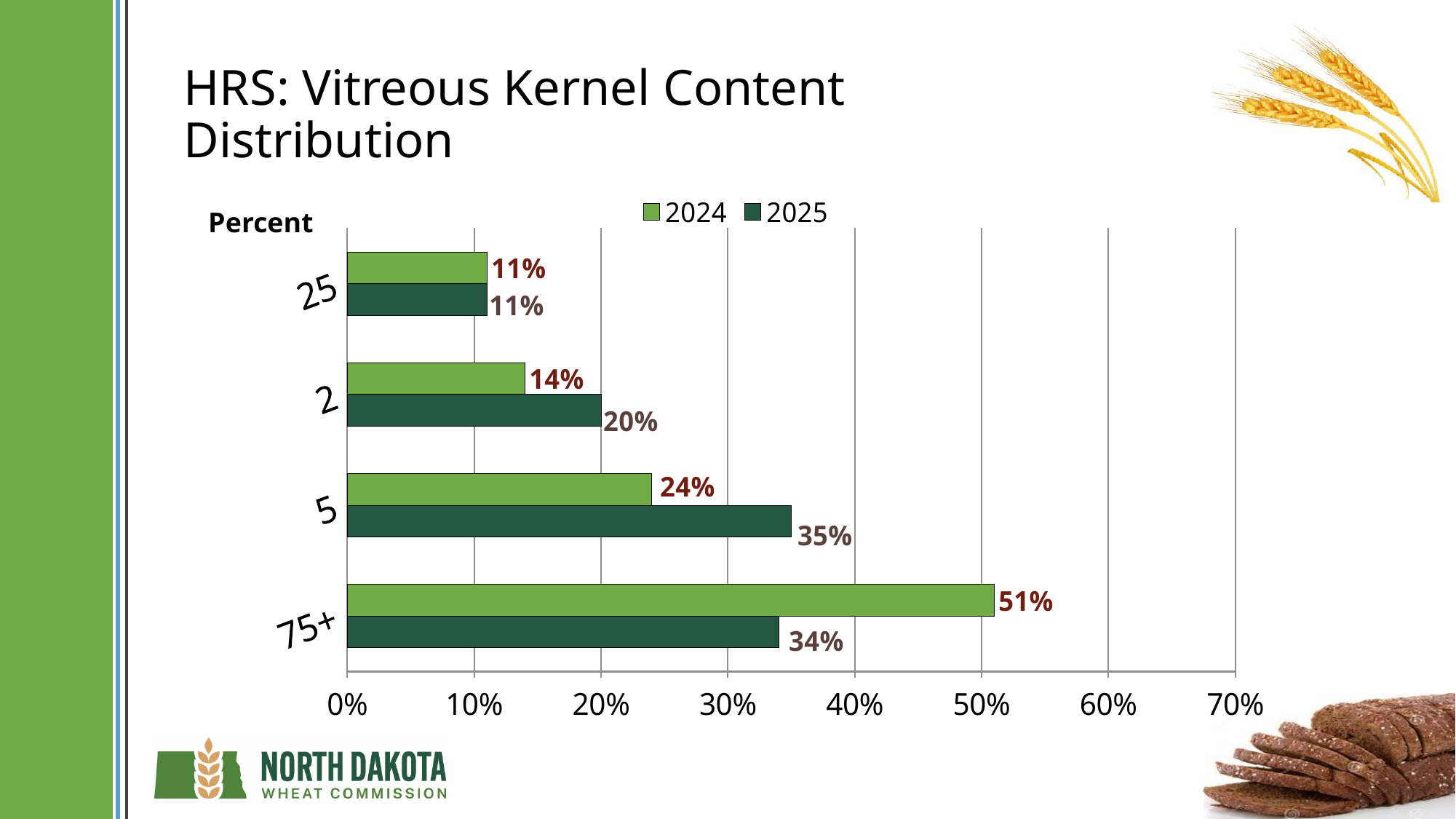
For the third category from the top, is the 2024 or the 2025 value larger? 2025 What is the 2025 value for the category labelled 25? 11% What is the 2024 value for the third category from the top? 24% What is the 2024 value for the 75+ category? 51% Which category has the highest 2024 value? 75+ What is the difference between the 2024 and 2025 values for the 75+ category? 17% What is the 2025 value for the second category from the top? 20% How many series does the legend list? 2 How many categories are shown on the chart? 4 Which category has the lowest 2025 value? 25 What type of chart is shown on the slide? bar chart What is the 2025 value for the 75+ category? 34%